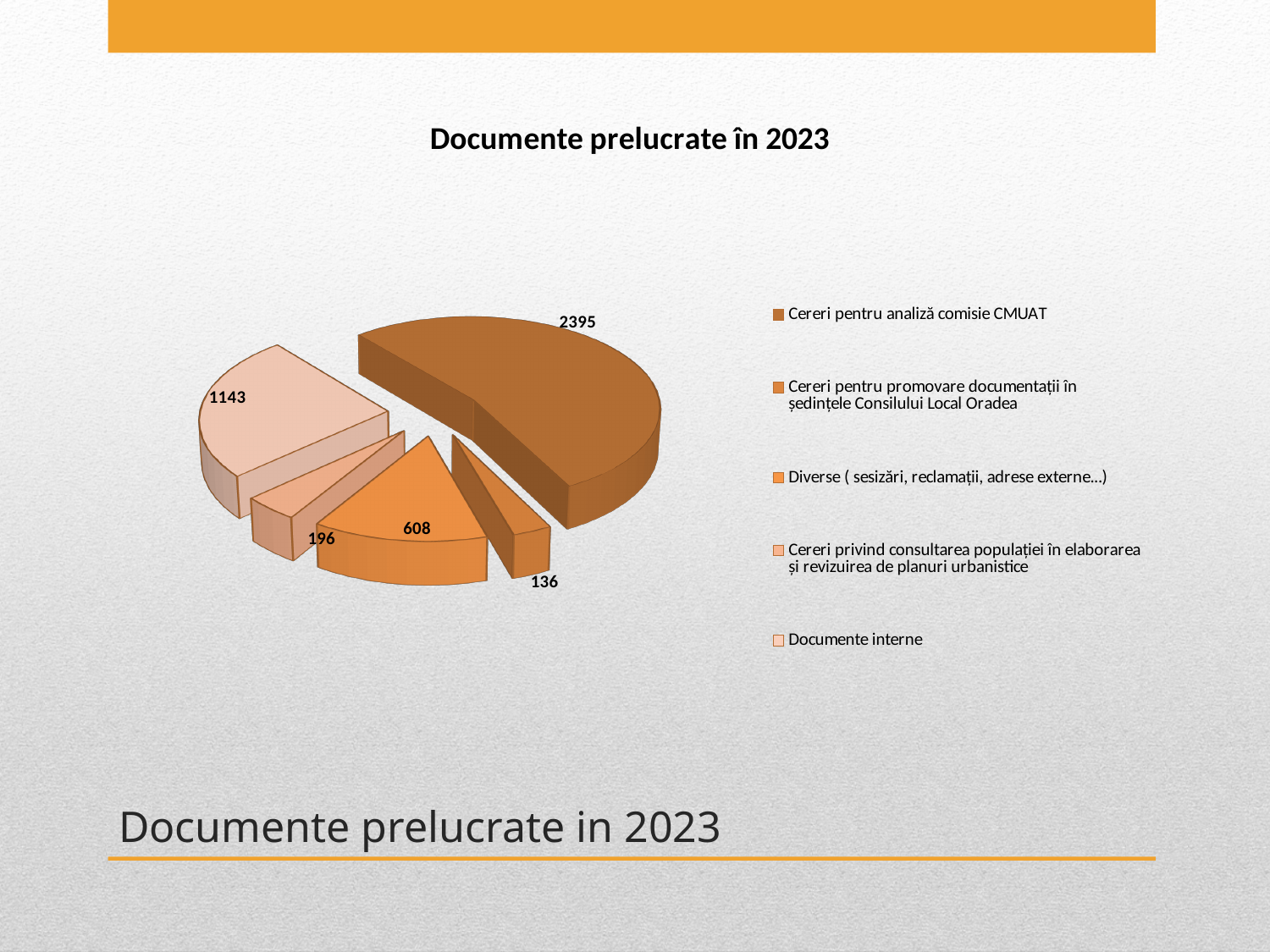
What is the value for Diverse ( sesizări, reclamații, adrese externe…)? 608 Which category has the smallest slice? Cereri pentru promovare documentații în ședințele Consilului Local Oradea Which category has the largest slice? Cereri pentru analiză comisie CMUAT What type of chart is shown on the slide? Pie chart How many slices does the pie chart have? 5 What is the title of the chart? Documente prelucrate în 2023 What is the total of all slices in the pie chart? 4478 What is the value for Cereri pentru analiză comisie CMUAT? 2395 Which is larger: the value for Diverse ( sesizări, reclamații, adrese externe…) or the value for Cereri privind consultarea populației în elaborarea și revizuirea de planuri urbanistice? Diverse ( sesizări, reclamații, adrese externe…) What is the difference between the value for Cereri pentru analiză comisie CMUAT and the value for Documente interne? 1252 How many entries does the legend list? 5 What is the value for Documente interne? 1143